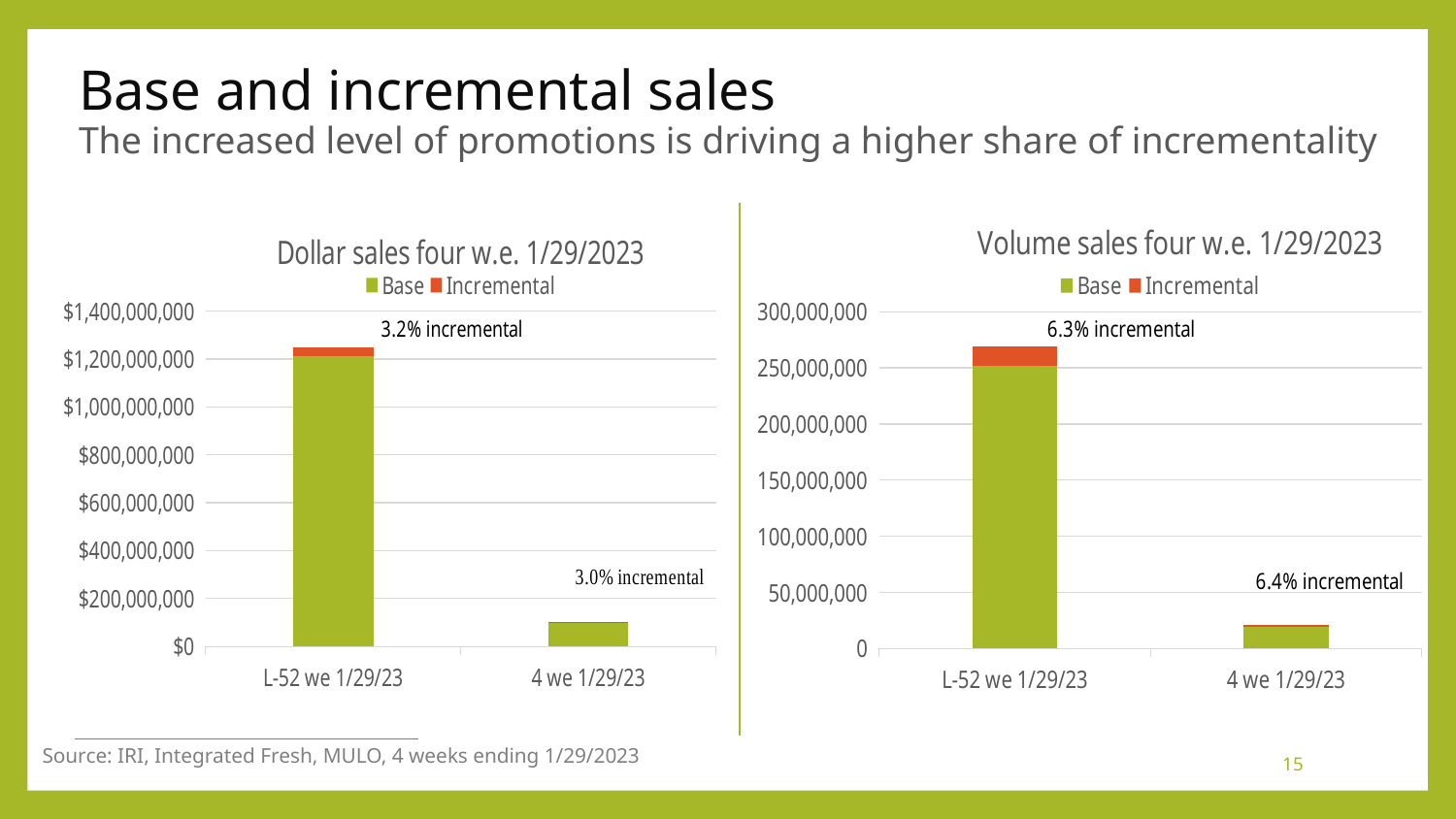
How many series does the legend list on the 'Volume sales four w.e. 1/29/2023' chart? 2 On the 'Volume sales four w.e. 1/29/2023' chart, what incremental percentage is labelled for 4 we 1/29/23? 6.4% incremental How many categories are shown on the x axis of the 'Dollar sales four w.e. 1/29/2023' chart? 2 On the 'Dollar sales four w.e. 1/29/2023' chart, is the total bar for L-52 we 1/29/23 greater or less than $1,000,000,000? greater On the 'Volume sales four w.e. 1/29/2023' chart, what incremental percentage is labelled for L-52 we 1/29/23? 6.3% incremental On the 'Volume sales four w.e. 1/29/2023' chart, is the total bar for 4 we 1/29/23 greater or less than 50,000,000? less Which series is shown in green on both charts? Base On the 'Volume sales four w.e. 1/29/2023' chart, which category has the shorter bar? 4 we 1/29/23 On the 'Dollar sales four w.e. 1/29/2023' chart, which category has the taller bar? L-52 we 1/29/23 What kind of chart is the 'Dollar sales four w.e. 1/29/2023' chart? Stacked bar chart On the 'Dollar sales four w.e. 1/29/2023' chart, what incremental percentage is labelled for 4 we 1/29/23? 3.0% incremental On the 'Dollar sales four w.e. 1/29/2023' chart, what incremental percentage is labelled for L-52 we 1/29/23? 3.2% incremental